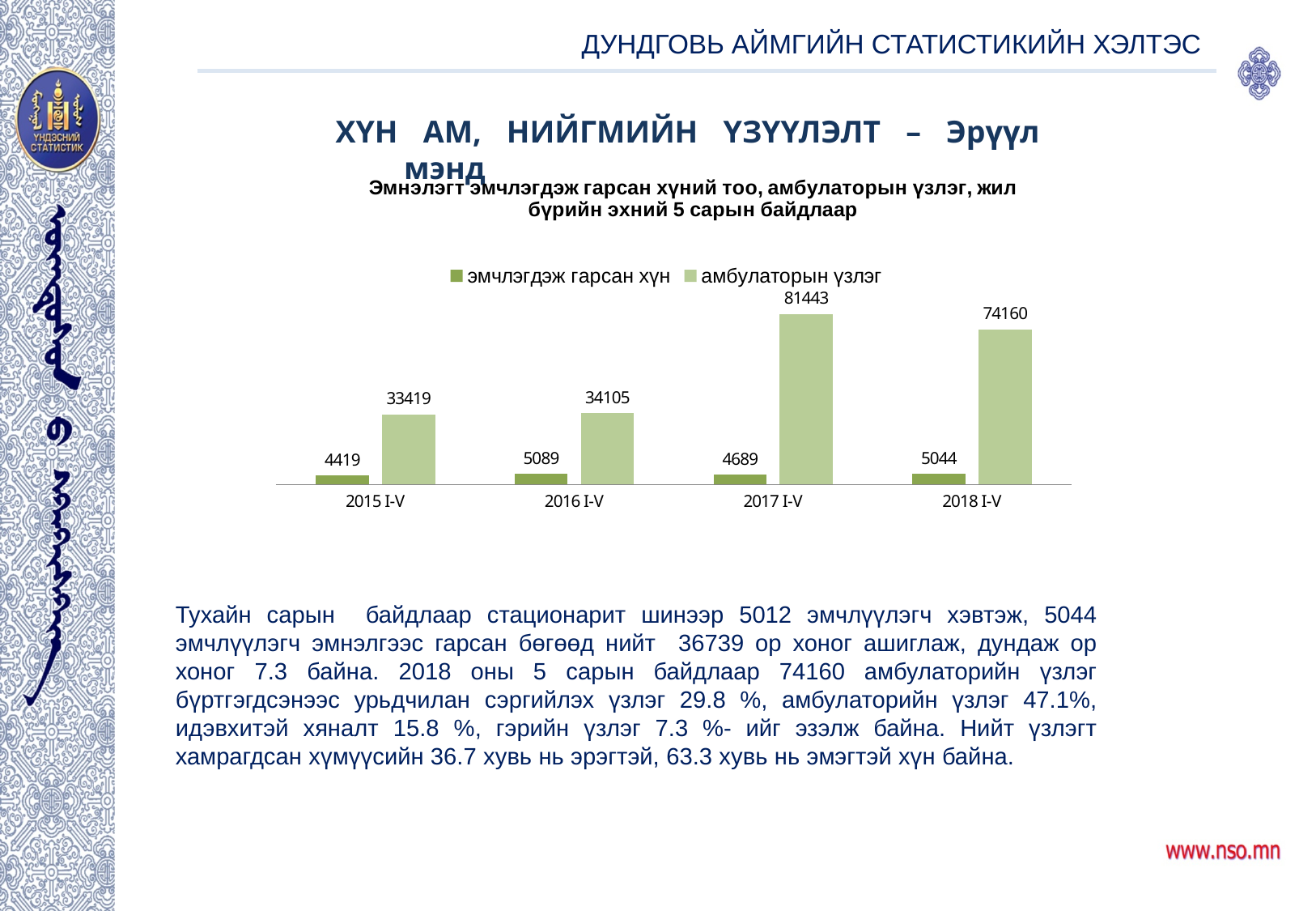
What is the difference between амбулаторын үзлэг in 2017 I-V and 2018 I-V? 7283 Which is larger: амбулаторын үзлэг in 2016 I-V or in 2015 I-V? 2016 I-V What is the difference between эмчлэгдэж гарсан хүн in 2016 I-V and 2015 I-V? 670 Which period has the highest value for амбулаторын үзлэг? 2017 I-V What are the two series named in the legend? эмчлэгдэж гарсан хүн and амбулаторын үзлэг How many periods are shown on the x axis? 4 What is the value for амбулаторын үзлэг in 2017 I-V? 81443 What is the value for амбулаторын үзлэг in 2015 I-V? 33419 What is the value for эмчлэгдэж гарсан хүн in 2016 I-V? 5089 How many series does the legend list? 2 What kind of chart is shown? bar chart Which period has the lowest value for эмчлэгдэж гарсан хүн? 2015 I-V